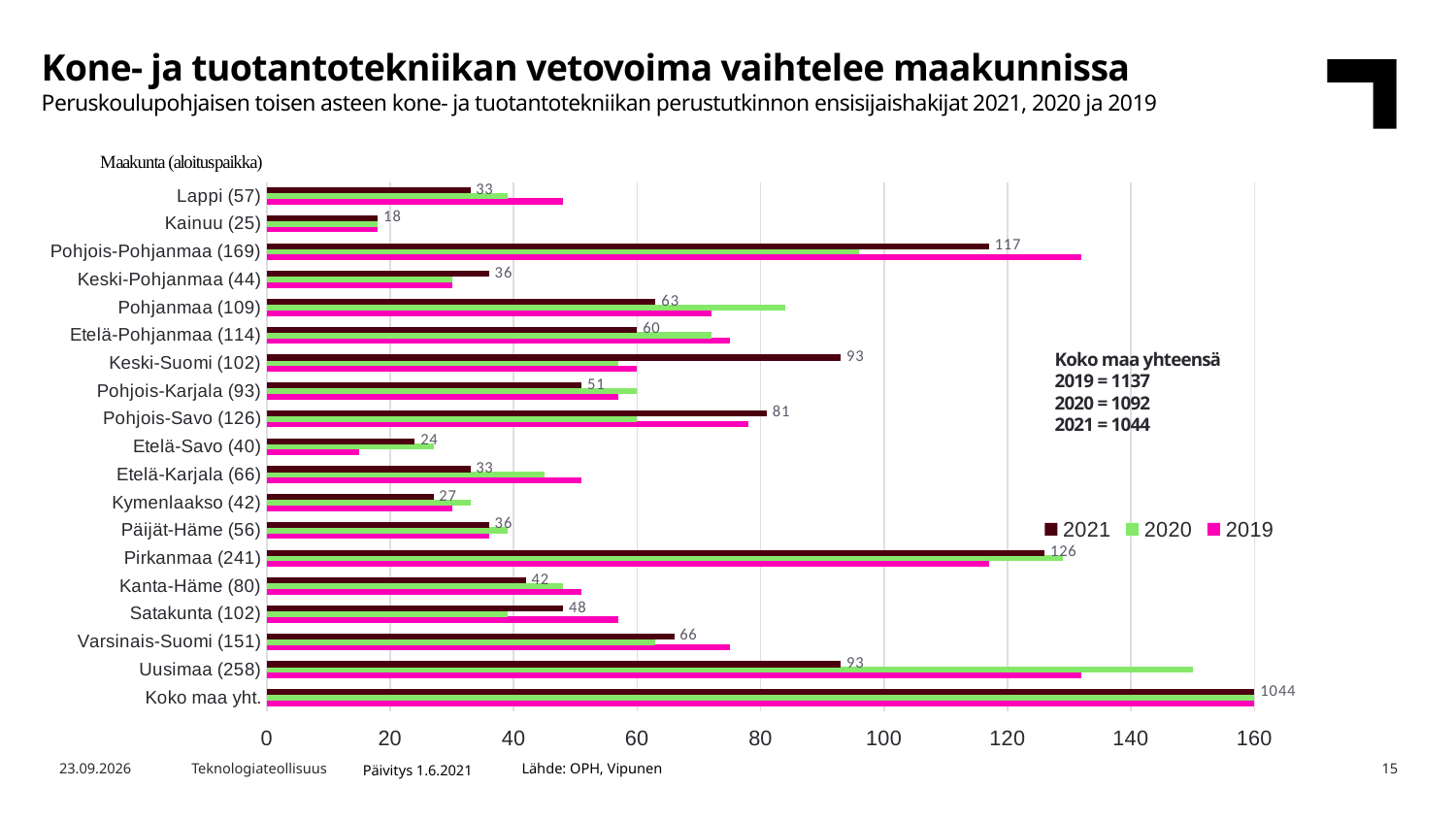
How many categories are shown on the vertical axis of the chart? 19 What is the difference between the 2021 values for Pirkanmaa (241) and Pohjois-Pohjanmaa (169)? 9 Which region has the lowest 2021 value? Kainuu (25) Which has the larger 2021 value, Keski-Suomi (102) or Pohjois-Savo (126)? Keski-Suomi (102) How many series does the legend list? 3 Is the 2019 value for Pohjois-Pohjanmaa (169) greater or less than 120? greater What kind of chart is shown on the slide? Bar chart Is the 2020 value for Uusimaa (258) greater or less than 140? greater What is the 2021 value for Pohjois-Savo (126)? 81 What is the 2021 value for Kainuu (25)? 18 Excluding the 'Koko maa yht.' row, which region has the highest 2021 value? Pirkanmaa (241) What is the 2021 value for Pohjois-Pohjanmaa (169)? 117